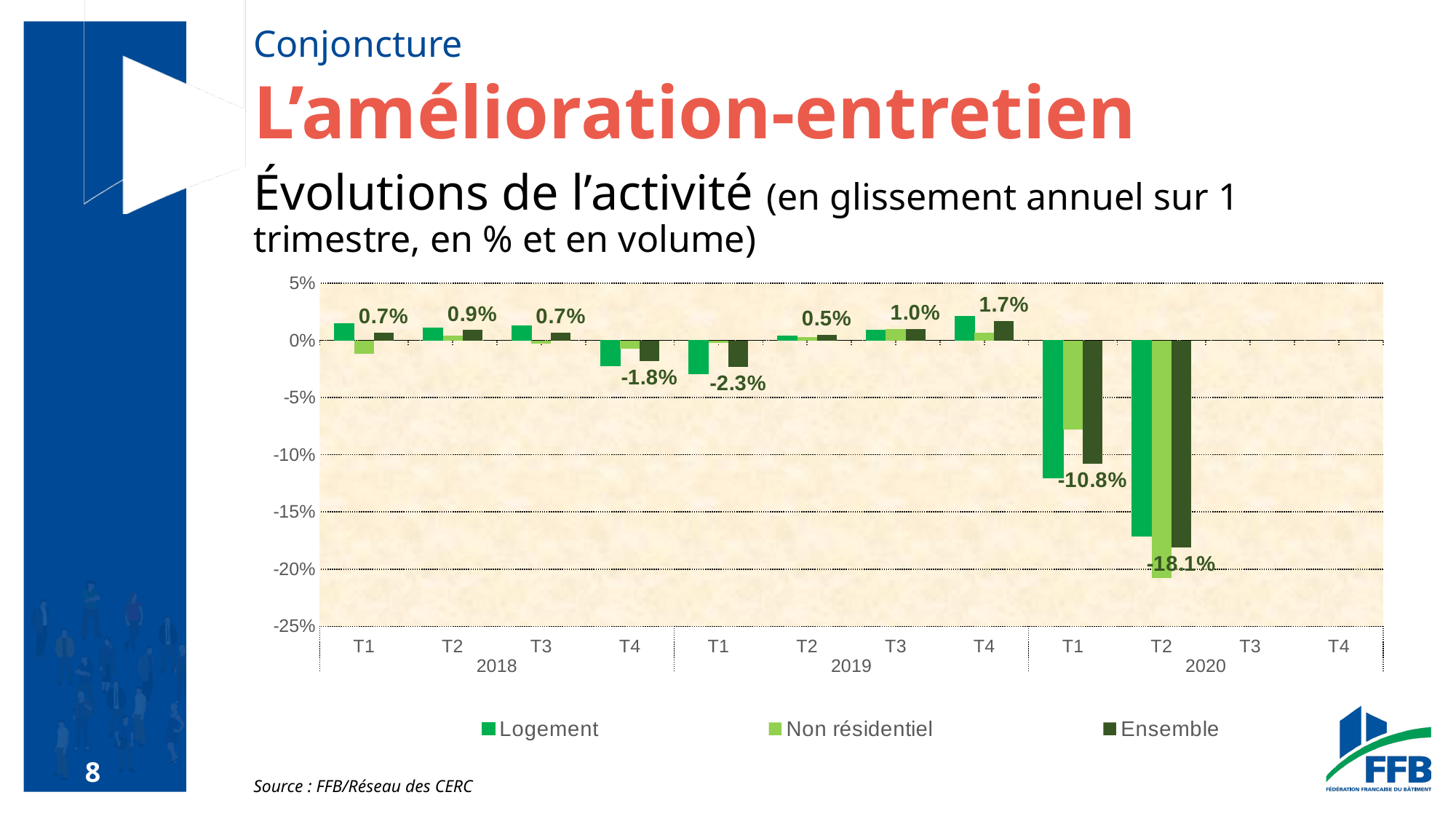
What is the value for Ensemble in T2 2020? -18.1% What is the difference between the Ensemble values for T1 2020 and T2 2020? 7.3 percentage points What is the value for Ensemble in T4 2019? 1.7% Which series is shown in the darkest green in the legend? Ensemble Is the value for Logement in T2 2020 greater or less than -15%? less What is the value for Ensemble in T1 2020? -10.8% In which quarter is the Ensemble value lowest? T2 2020 What is the value for Ensemble in T1 2019? -2.3% How many series does the legend list? 3 What kind of chart is shown on the slide? Bar chart In which quarter is the Ensemble value highest? T4 2019 Which is larger, the Ensemble value for T2 2018 or for T3 2019? T3 2019